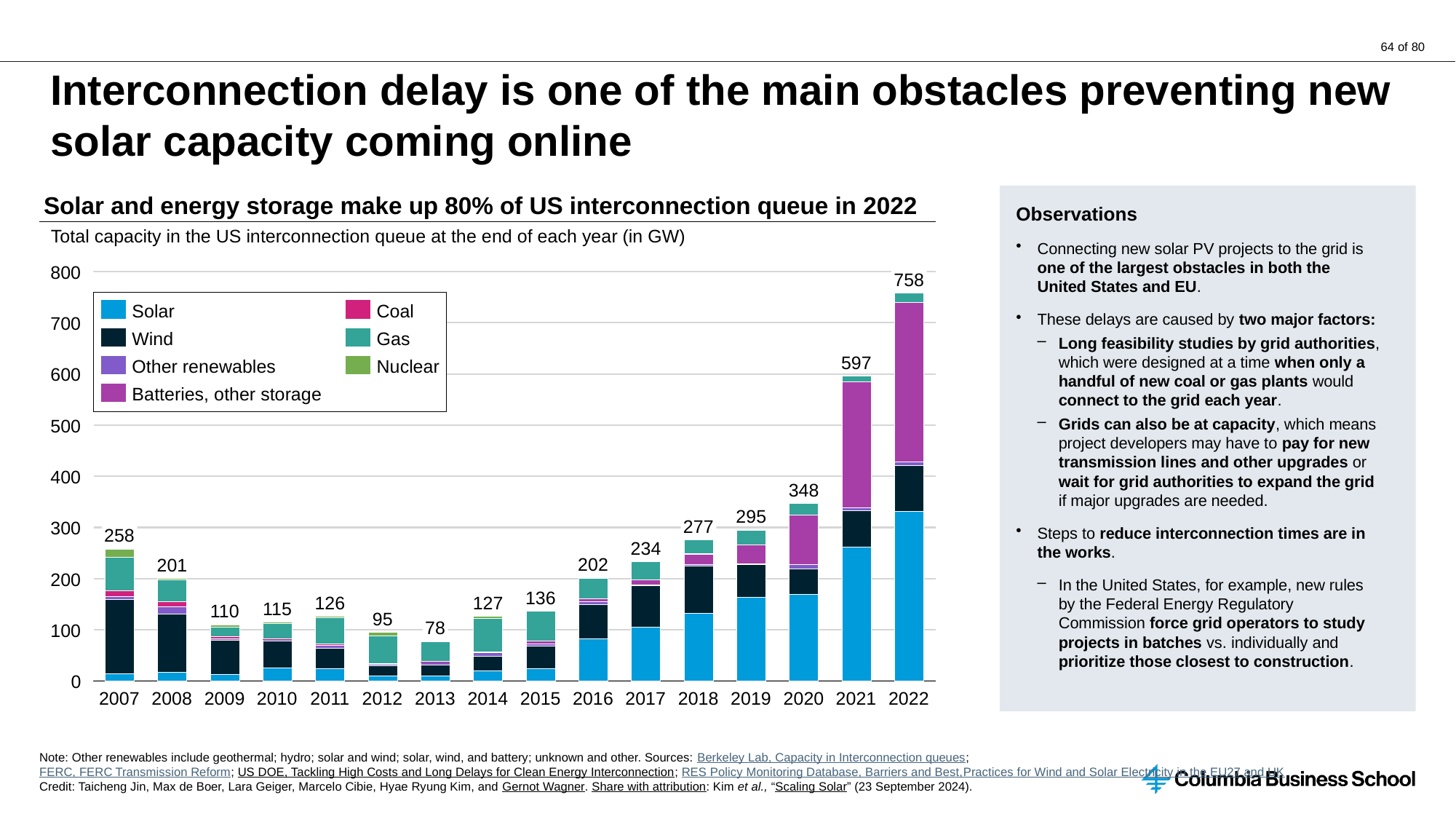
Which colour represents Batteries, other storage in the chart legend? Purple Which year has the highest total capacity in the interconnection queue? 2022 Which year has a larger total queue capacity, 2007 or 2020? 2020 How many series does the chart legend list? 7 What is the total capacity in the US interconnection queue at the end of 2022? 758 What kind of chart is shown on the slide? Stacked bar chart How many years are shown on the x axis of the chart? 16 Which year has the lowest total capacity in the interconnection queue? 2013 What is the total capacity in the US interconnection queue at the end of 2013? 78 Is the Solar value for 2022 greater or less than 300? greater Does the total queue capacity rise or fall from 2013 to 2022? Rise What is the difference between the total queue capacity in 2022 and in 2021? 161